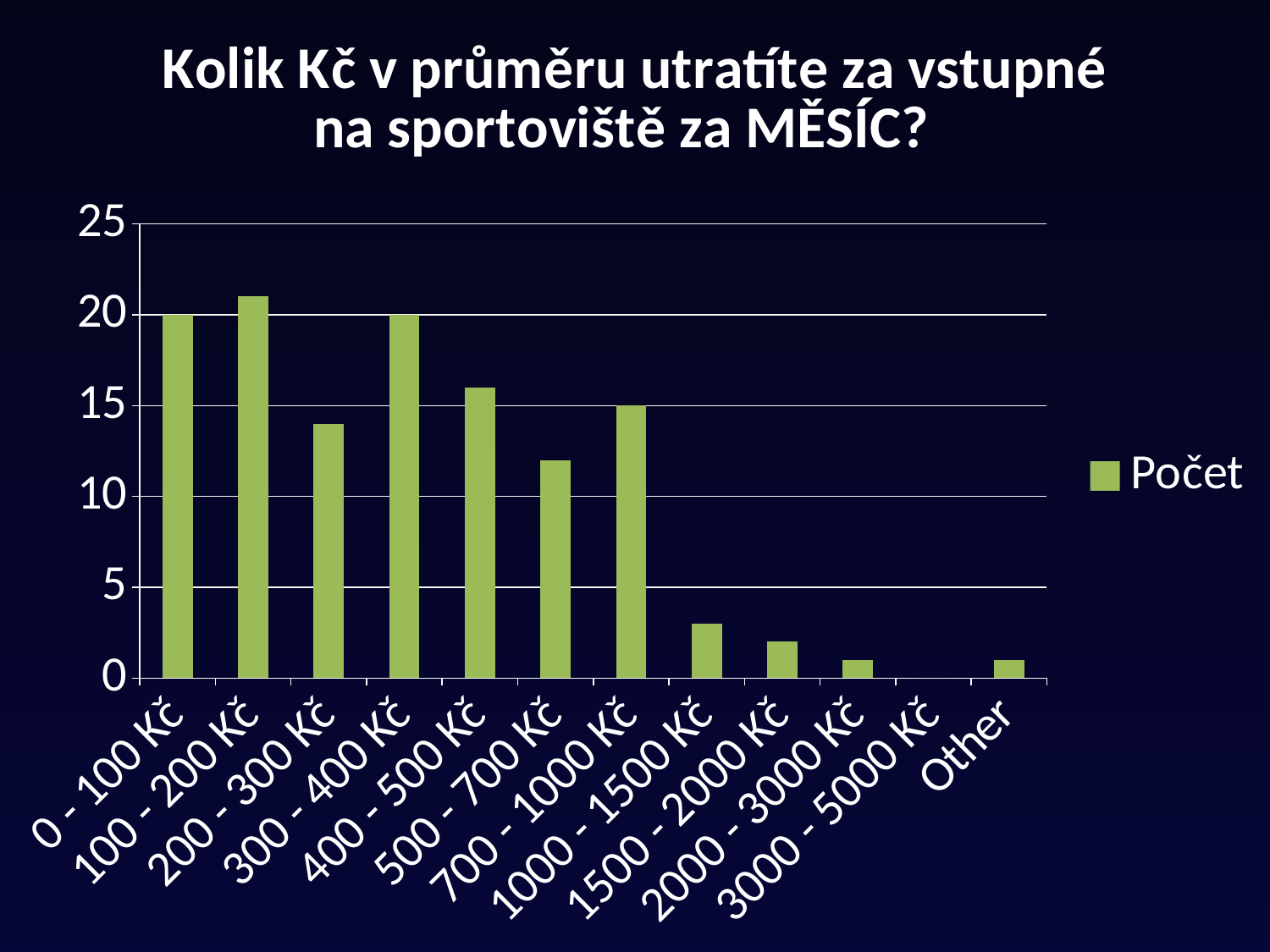
What is the name of the series shown in the legend? Počet What is the value for 3000 - 5000 Kč? 0 What kind of chart is shown on the slide? bar chart Is the value for 400 - 500 Kč greater or less than 15? greater Which category has the lowest value? 3000 - 5000 Kč Is the value for 200 - 300 Kč greater or less than 15? less What is the value for 700 - 1000 Kč? 15 Which is larger, the value for 400 - 500 Kč or the value for 500 - 700 Kč? 400 - 500 Kč Is the value for 1000 - 1500 Kč greater or less than 5? less How many categories are shown on the x axis? 12 Which category has the highest value? 100 - 200 Kč How many series does the legend list? 1